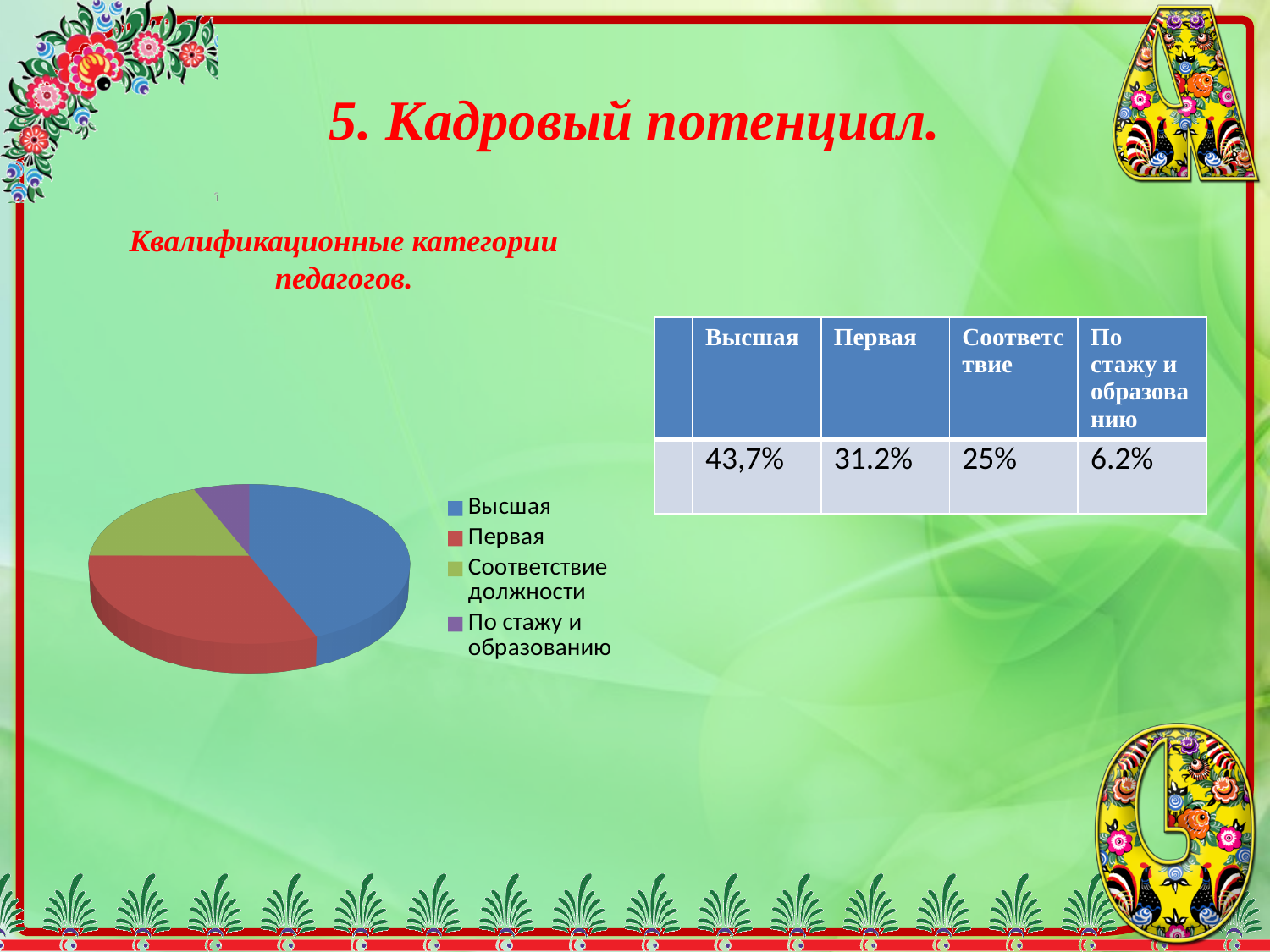
Which category has the largest slice in the pie chart? Высшая According to the table on the slide, what is the share for Первая? 31.2% Which slice is larger in the pie chart: Первая or Соответствие должности? Первая According to the table on the slide, what is the share for Соответствие? 25% Which slice is larger in the pie chart: Высшая or Первая? Высшая According to the table on the slide, what is the share for По стажу и образованию? 6.2% According to the table on the slide, what is the share for Высшая? 43,7% How many slices does the pie chart have? 4 Which category has the smallest slice in the pie chart? По стажу и образованию What colour is the Высшая slice in the pie chart? blue What kind of chart is shown on the slide? pie chart How many entries does the pie chart's legend list? 4